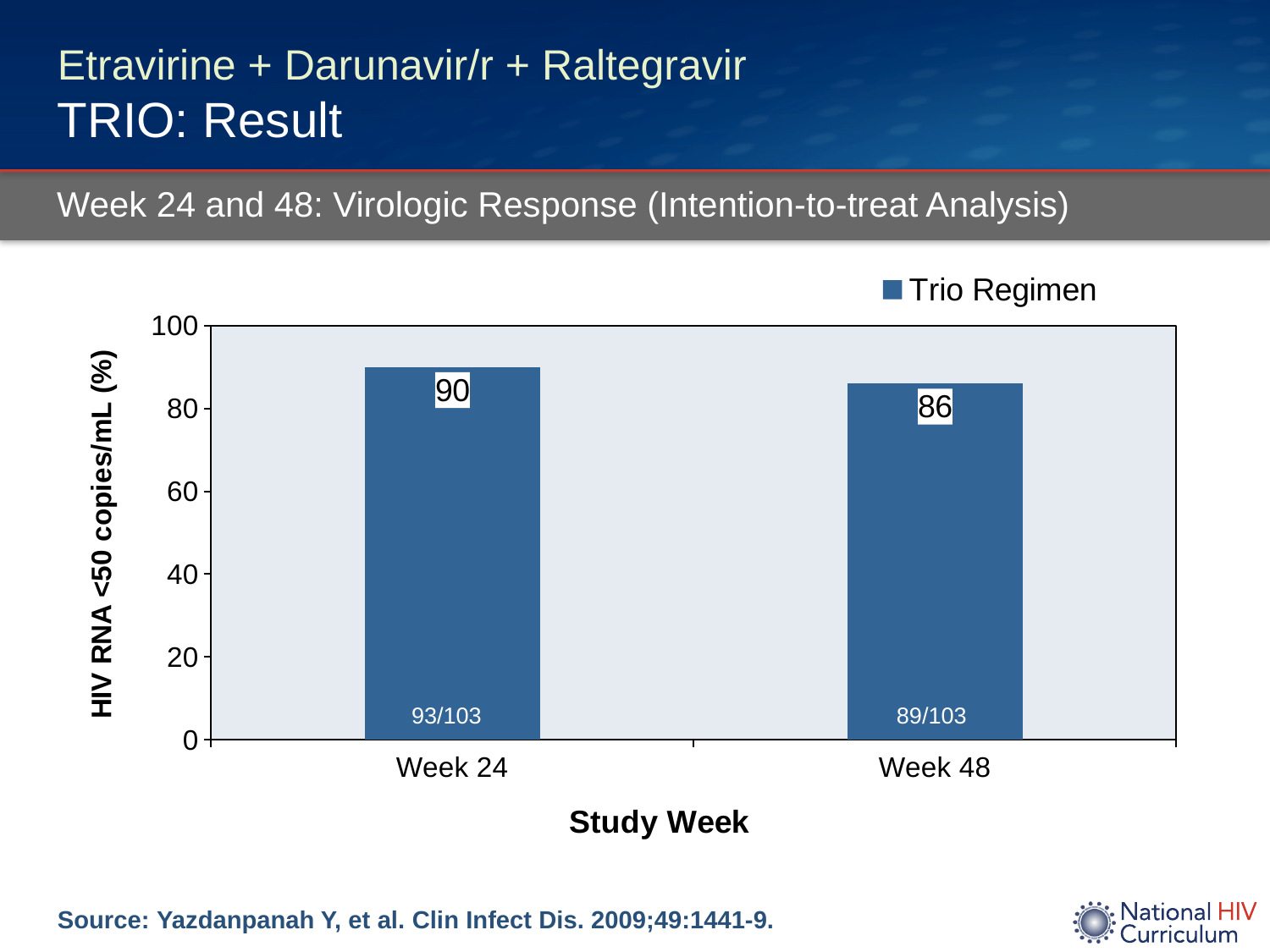
Which study week has the highest value? Week 24 What is the value for Week 48? 86 Which is larger, the value for Week 24 or Week 48? Week 24 Is the value for Week 48 greater or less than 80? greater Which study week has the lowest value? Week 48 What is the difference between the values for Week 24 and Week 48? 4 How many series does the legend list? 1 How many study weeks are shown on the x axis? 2 What kind of chart is shown? bar chart What is the name of the series in the legend? Trio Regimen Do the values rise or fall from Week 24 to Week 48? fall What is the value for Week 24? 90